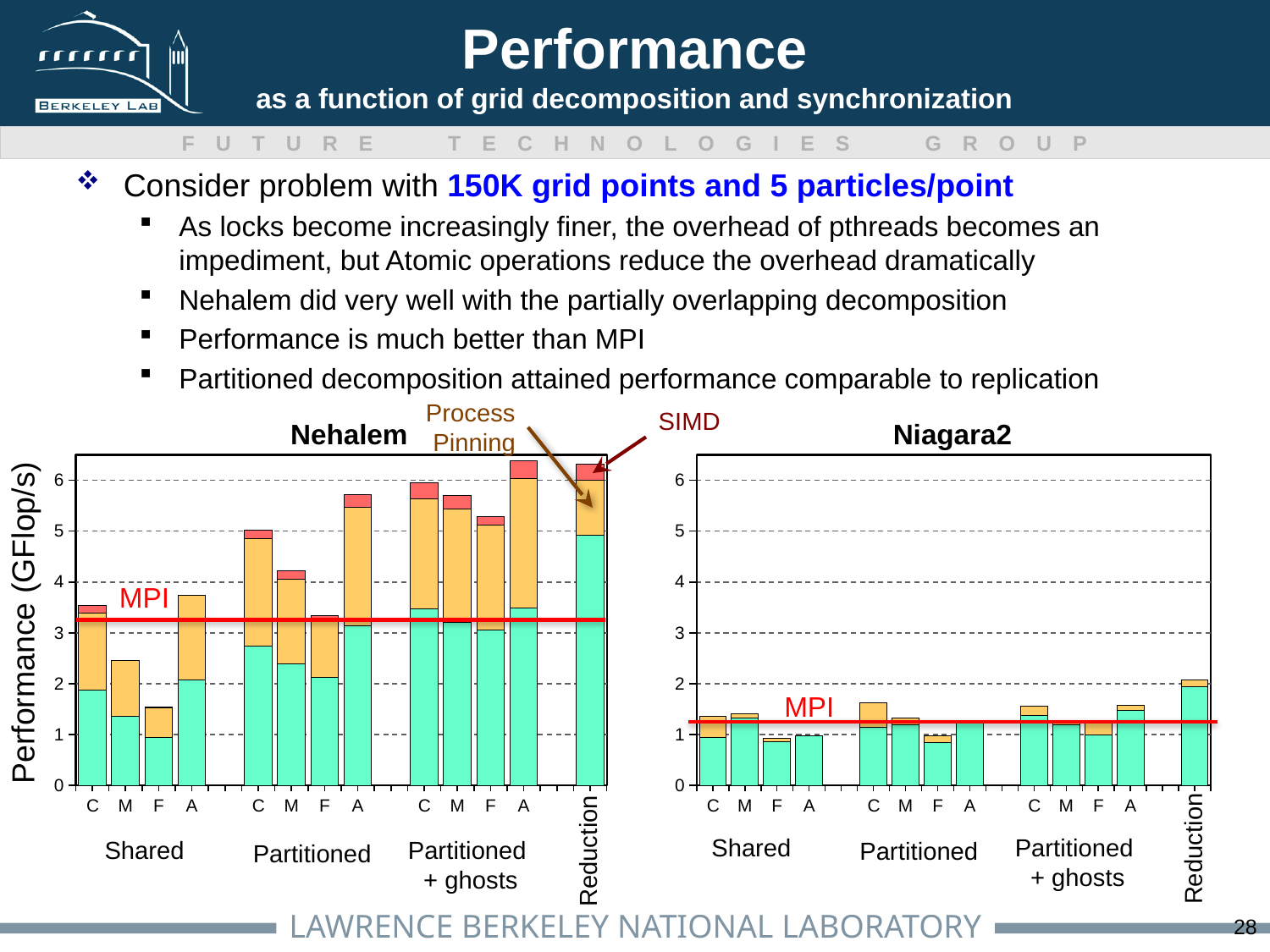
In the Nehalem chart, is the total value for A under Partitioned greater or less than 5? greater In the Nehalem chart, which bar is the lowest? F (Shared) In the Niagara2 chart, which bar is the highest? Reduction In the Niagara2 chart, which bar is taller: C under Partitioned or M under Partitioned? C under Partitioned In the Nehalem chart, which bar is taller: C under Partitioned or M under Partitioned? C under Partitioned What is the y-axis label shared by the two charts? Performance (GFlop/s) In the Nehalem chart, is the total value for M under Shared greater or less than 3? less In the Nehalem chart, is the total value for C under Shared greater or less than 3? greater How many bars are plotted in the Niagara2 chart? 13 What kind of chart is the Nehalem chart? bar chart